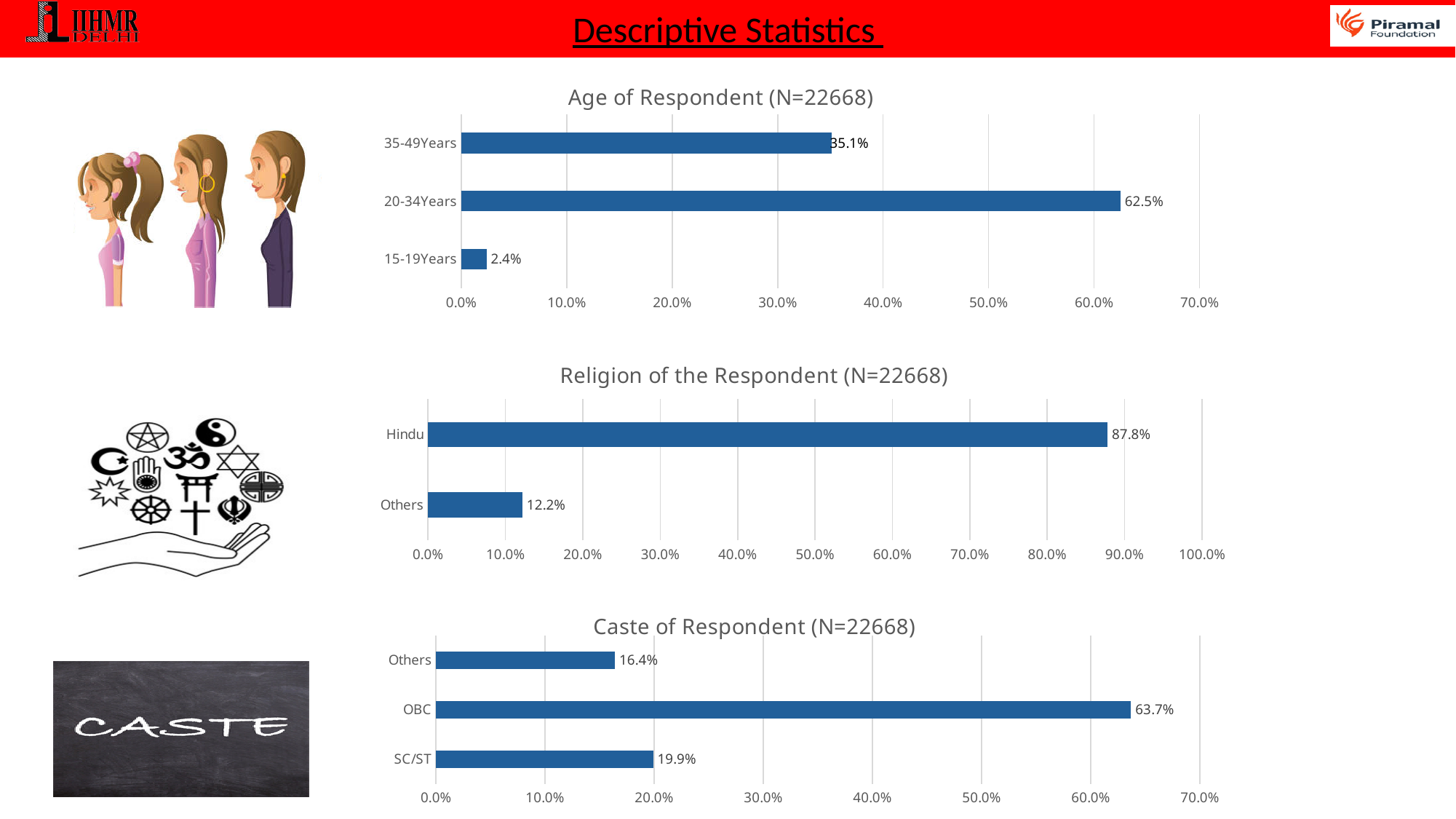
What is the title of the middle chart on the slide? Religion of the Respondent (N=22668) In the 'Religion of the Respondent (N=22668)' chart, what is the value for Hindu? 87.8% In the 'Religion of the Respondent (N=22668)' chart, what is the difference between the values for Hindu and Others? 75.6% In the 'Age of Respondent (N=22668)' chart, how many age categories are shown? 3 In the 'Age of Respondent (N=22668)' chart, what is the difference between the values for 20-34Years and 35-49Years? 27.4% What kind of chart is the 'Caste of Respondent (N=22668)' chart? Bar chart In the 'Religion of the Respondent (N=22668)' chart, is the value for Others greater or less than 20.0%? less In the 'Caste of Respondent (N=22668)' chart, which is larger, the value for SC/ST or the value for Others? SC/ST In the 'Age of Respondent (N=22668)' chart, which age group has the lowest value? 15-19Years In the 'Age of Respondent (N=22668)' chart, what is the value for 20-34Years? 62.5% In the 'Caste of Respondent (N=22668)' chart, which caste category has the highest value? OBC In the 'Caste of Respondent (N=22668)' chart, what is the value for SC/ST? 19.9%